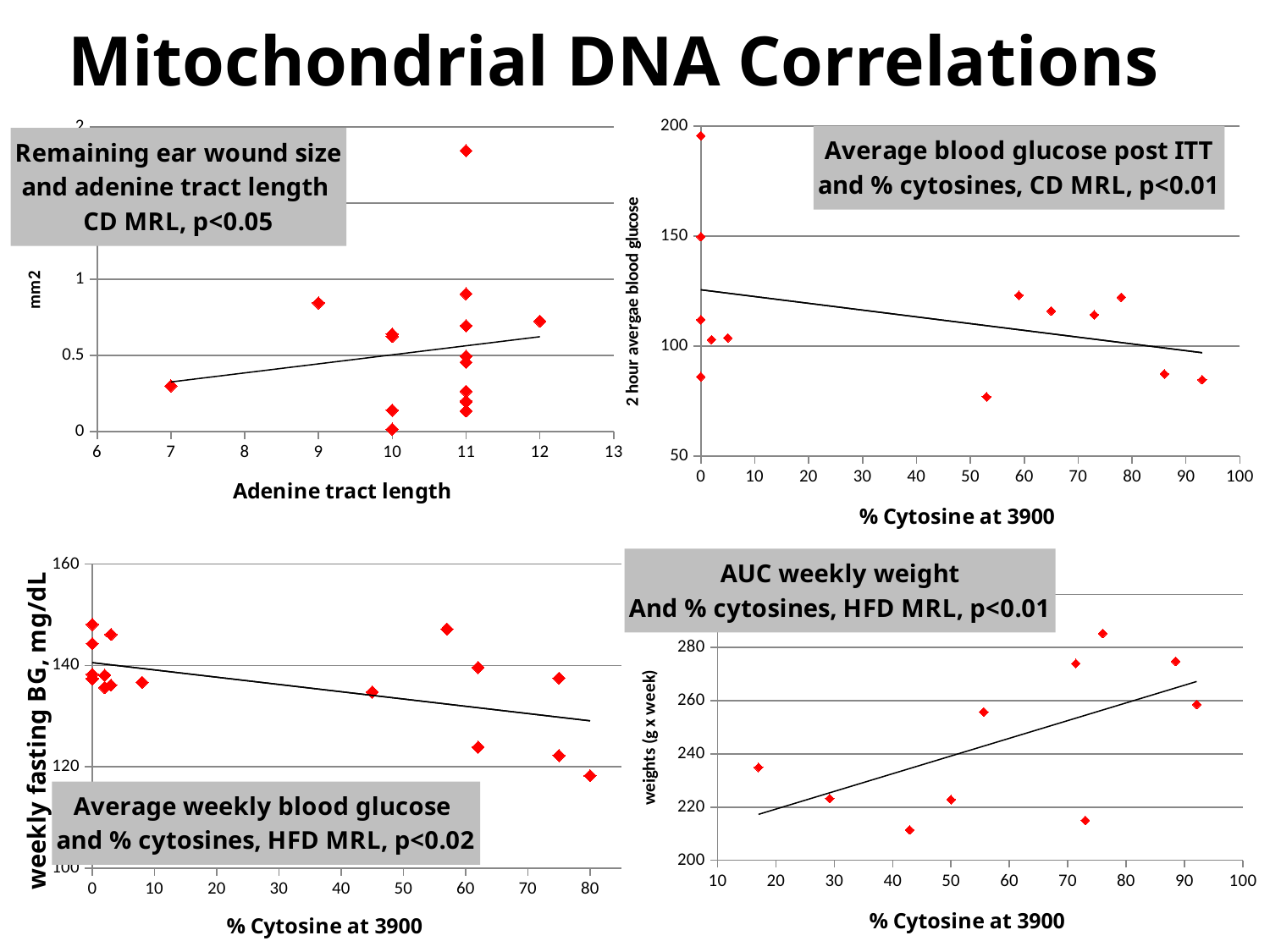
In the top-right chart, 'Average blood glucose post ITT and % cytosines', is the highest plotted point greater or less than 150? greater What kind of chart is the top-left chart, 'Remaining ear wound size and adenine tract length'? scatter chart In the top-left chart, 'Remaining ear wound size and adenine tract length', is the highest plotted point greater or less than 1.5? greater In the bottom-left chart, 'Average weekly blood glucose and % cytosines', does the fitted trend line rise or fall as % cytosine increases? fall In the bottom-right chart, 'AUC weekly weight and % cytosines', is the highest plotted point greater or less than 280? greater In the top-left chart, 'Remaining ear wound size and adenine tract length', does the fitted trend line rise or fall as adenine tract length increases? rise In the bottom-right chart, 'AUC weekly weight and % cytosines', does the fitted trend line rise or fall as % cytosine increases? rise What is the y-axis title of the bottom-right chart, 'AUC weekly weight and % cytosines'? weights (g x week) How many data points are plotted in the bottom-right chart, 'AUC weekly weight and % cytosines'? 10